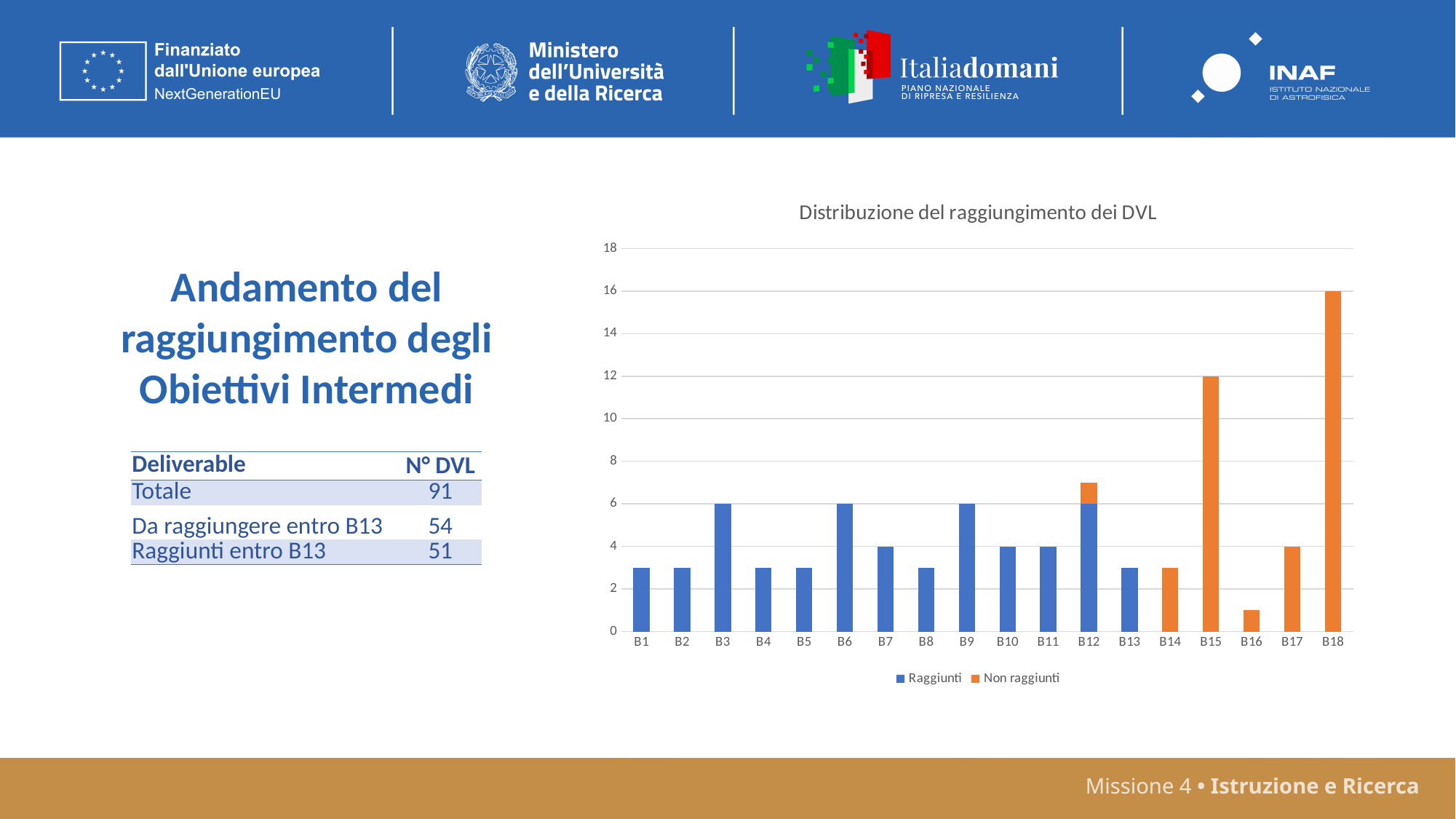
Which category has the highest bar in the chart? B18 What is the value of the Raggiunti bar for B3? 6 How many categories are shown on the x axis of the chart? 18 What kind of chart is shown on the slide? bar chart What is the value of the Raggiunti bar for B7? 4 What is the value of the Non raggiunti bar for B15? 12 How many series does the chart legend list? 2 Which series is shown in orange in the chart? Non raggiunti What is the title of the chart? Distribuzione del raggiungimento dei DVL Is the value for B1 greater or less than 4? less Which is larger, the bar for B15 or the bar for B17? B15 What is the value of the Non raggiunti bar for B18? 16